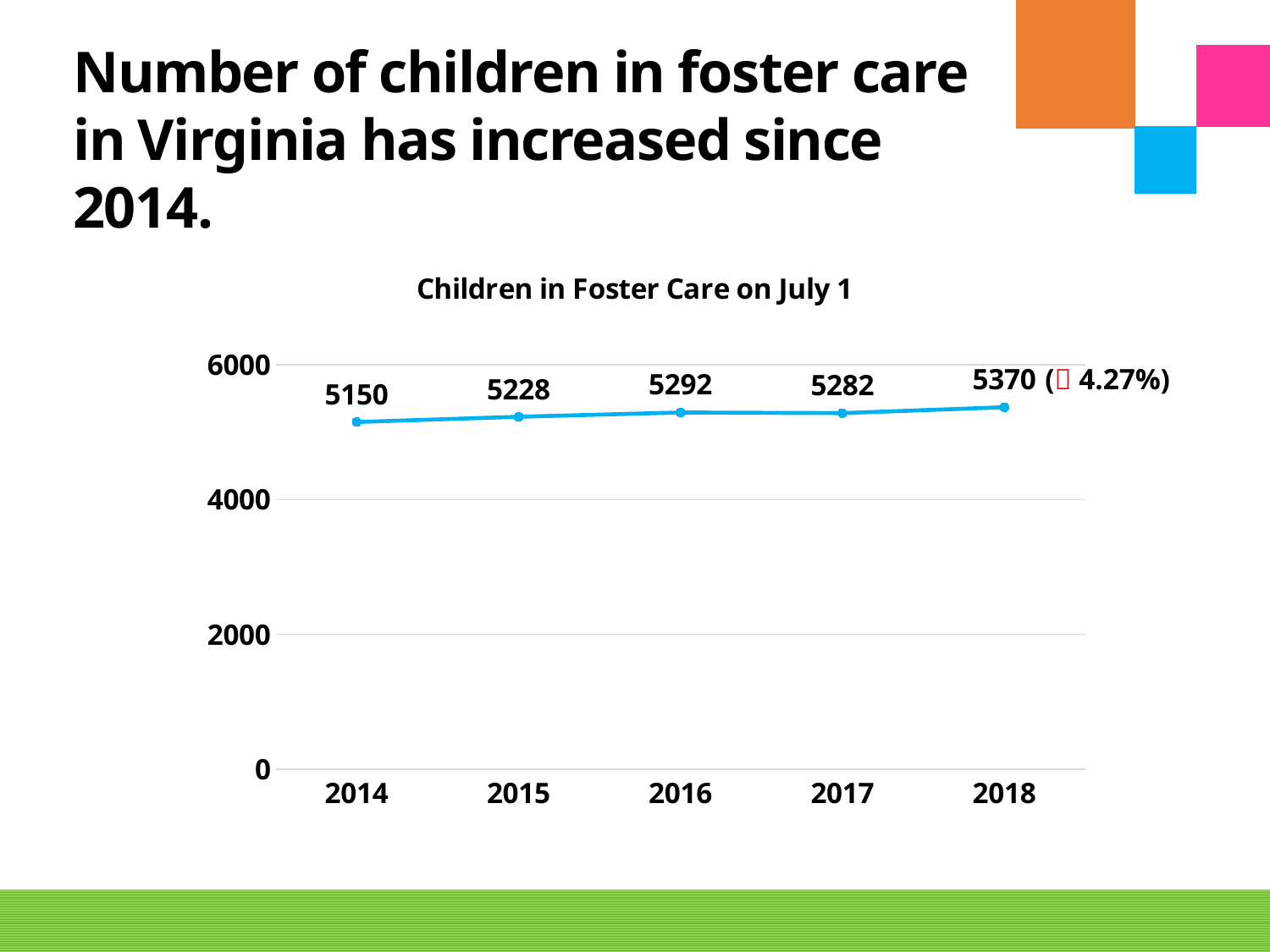
Overall, do the values rise or fall from 2014 to 2018? Rise Which year has the highest number of children in foster care? 2018 How many years are plotted on the chart? 5 What is the number of children in foster care on July 1, 2018? 5370 What is the number of children in foster care on July 1, 2014? 5150 What is the difference between the number of children in foster care in 2018 and in 2014? 220 What kind of chart is shown on the slide? Line chart Which year has more children in foster care, 2015 or 2016? 2016 Which year has the lowest number of children in foster care? 2014 What is the title of the chart? Children in Foster Care on July 1 What is the difference between the number of children in foster care in 2016 and in 2017? 10 What is the number of children in foster care on July 1, 2017? 5282